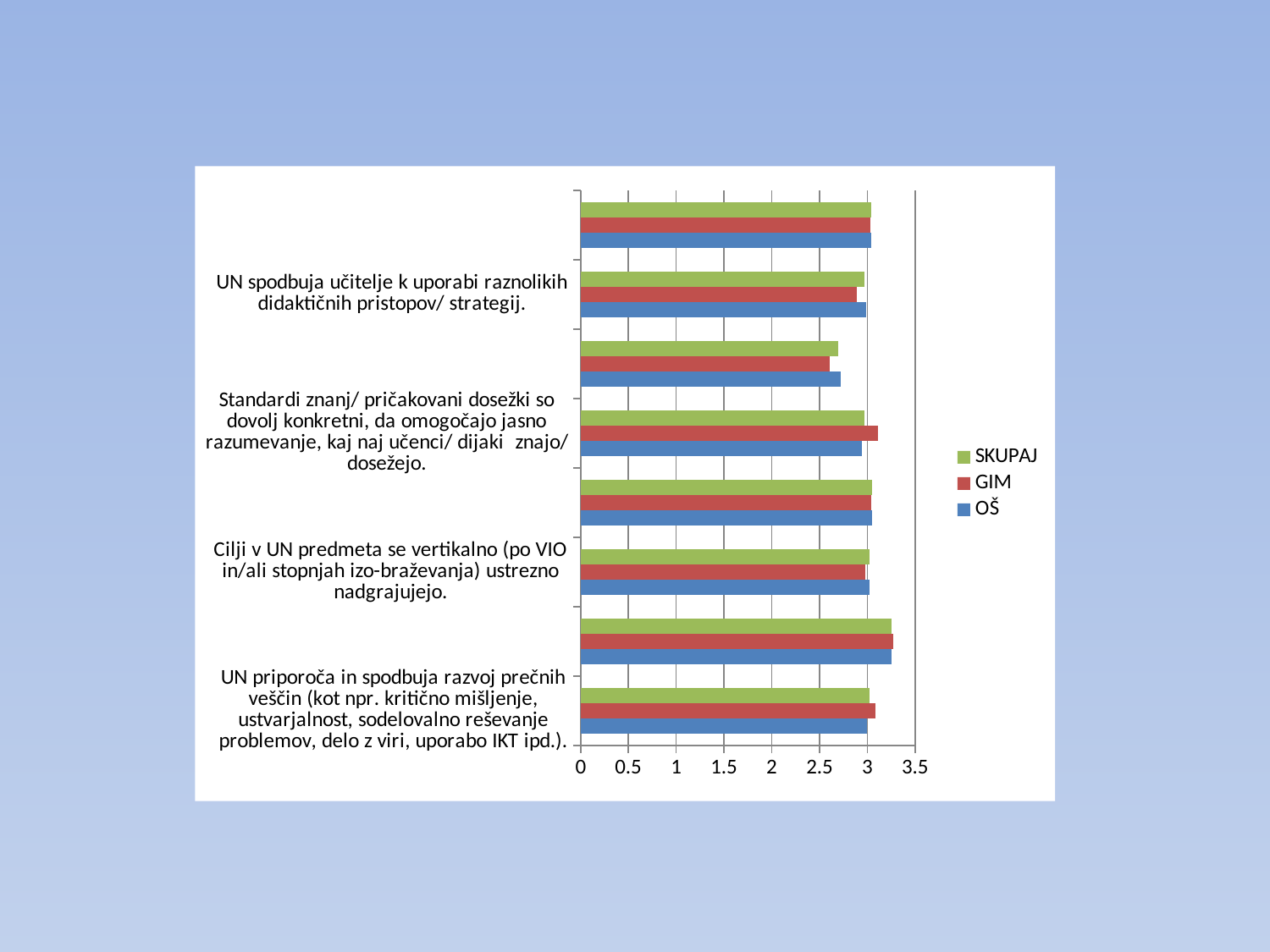
Which colour represents the OŠ series? blue Is the value for SKUPAJ for 'Standardi znanj/ pričakovani dosežki so dovolj konkretni' greater or less than 1.5? greater How many category groups of bars are plotted on the chart? 8 What kind of chart is shown on the slide? bar chart Is the value for SKUPAJ for 'UN priporoča in spodbuja razvoj prečnih veščin' greater or less than 3.5? less What are the series names listed in the legend? SKUPAJ, GIM, OŠ What is the highest value shown on the horizontal axis? 3.5 How many bars are shown for each category group? 3 Is the value for OŠ for 'UN spodbuja učitelje k uporabi raznolikih didaktičnih pristopov/ strategij.' greater or less than 2.5? greater How many series does the legend list? 3